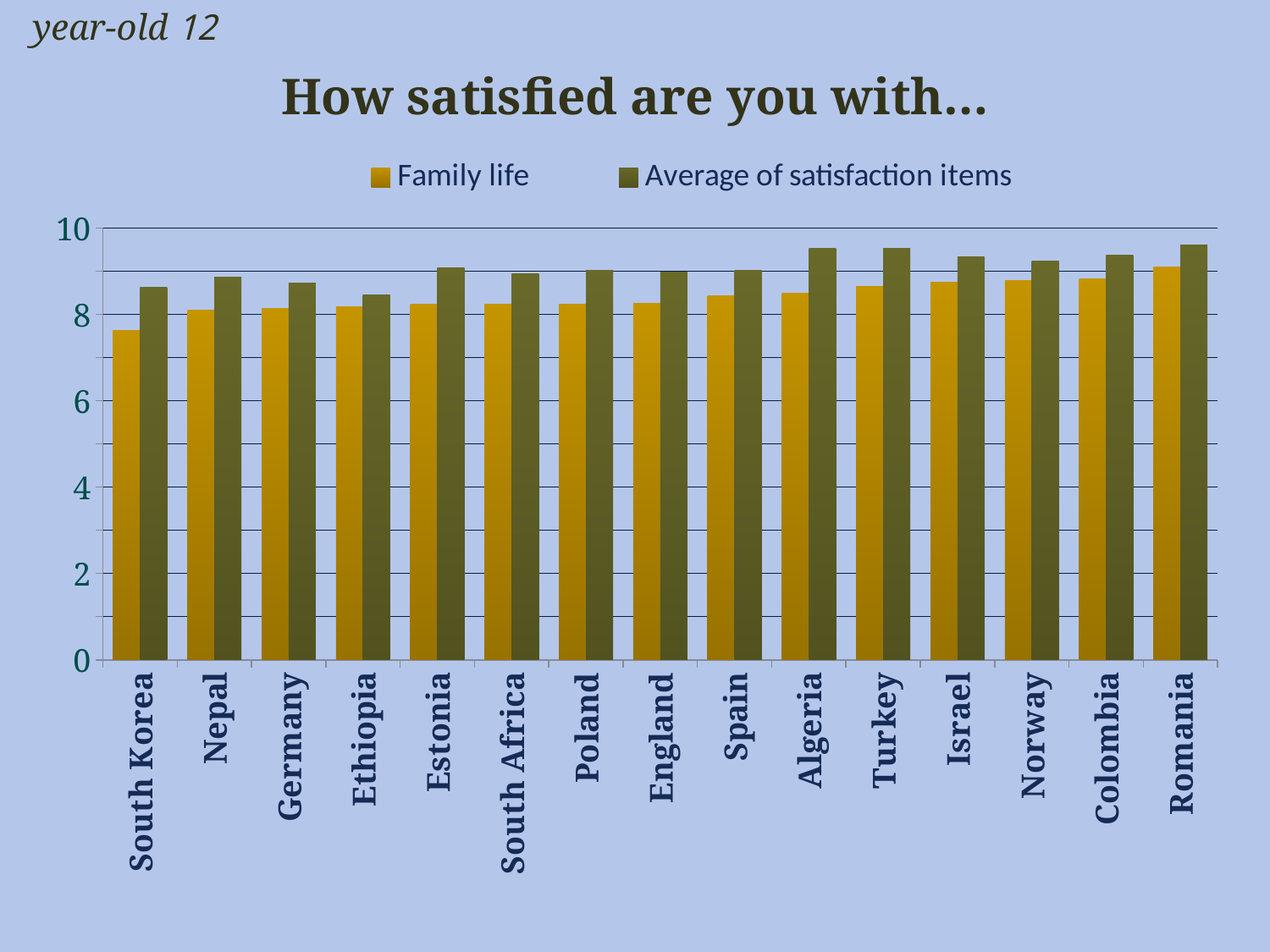
Is the Family life value for Romania greater or less than 8? greater Which country has the highest value for Family life? Romania How many countries are shown on the x axis of the chart? 15 What kind of chart is shown on the slide? bar chart How many series does the chart's legend list? 2 Is the Family life value for South Korea greater or less than 8? less For South Korea, which is larger: Family life or Average of satisfaction items? Average of satisfaction items Which country has the lowest value for Family life? South Korea Is the Average of satisfaction items value for Algeria greater or less than 8? greater What is the title of the chart? How satisfied are you with... Do the Family life values generally rise or fall from South Korea to Romania along the x axis? rise Which series is shown in the darker olive-green bars? Average of satisfaction items